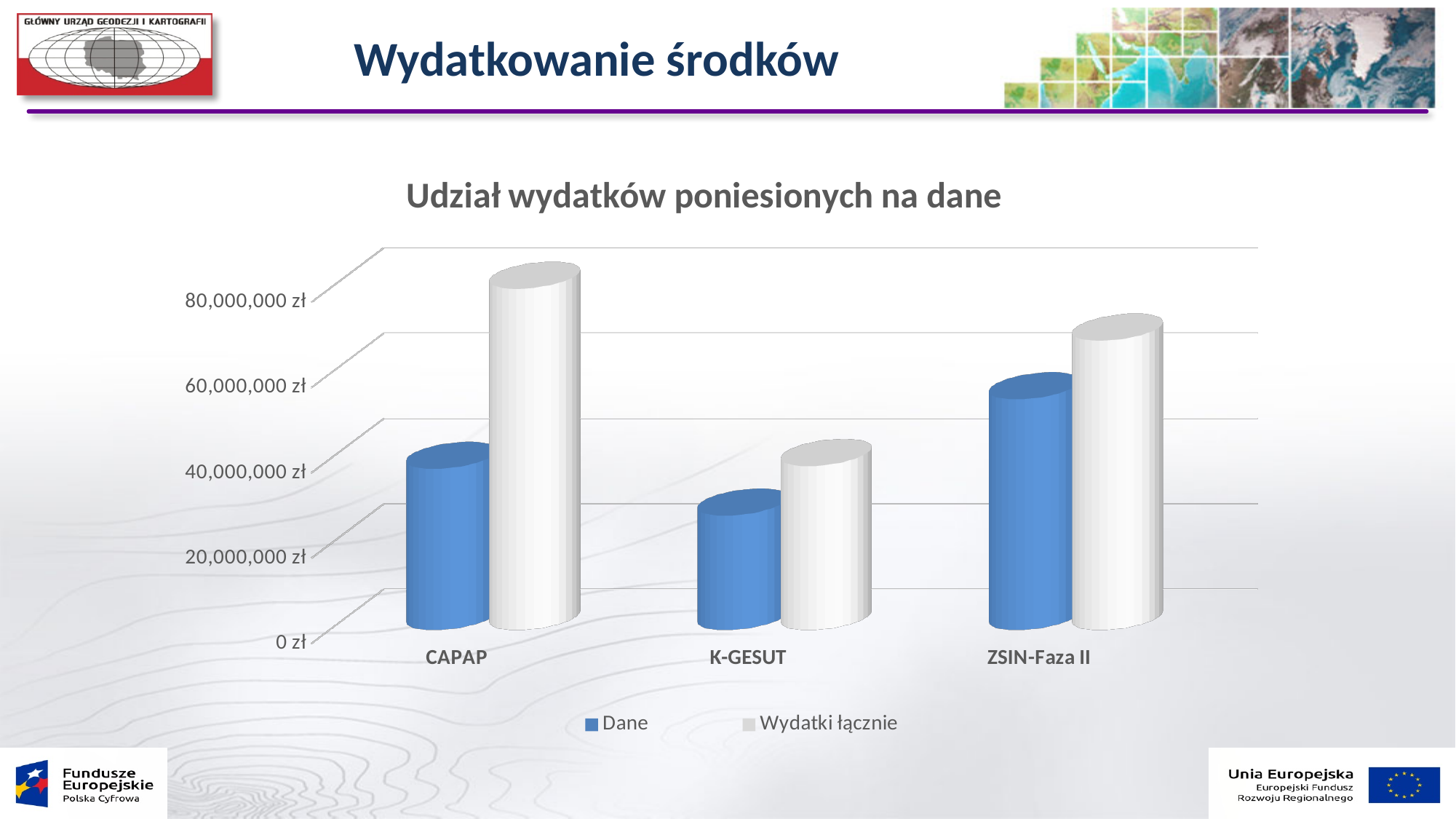
What is the title of the chart? Udział wydatków poniesionych na dane Is the Dane value for K-GESUT greater or less than 40,000,000 zł? less Which category has the highest value for the Wydatki łącznie series? CAPAP Which category has the highest value for the Dane series? ZSIN-Faza II Is the Dane value for ZSIN-Faza II greater or less than 40,000,000 zł? greater Which is larger for K-GESUT: the Dane value or the Wydatki łącznie value? Wydatki łącznie How many series does the legend list? 2 Which category has the lowest value for the Dane series? K-GESUT Is the Wydatki łącznie value for CAPAP greater or less than 60,000,000 zł? greater Which category has the lowest value for the Wydatki łącznie series? K-GESUT What kind of chart is shown on the slide? bar chart How many categories are shown on the x axis? 3